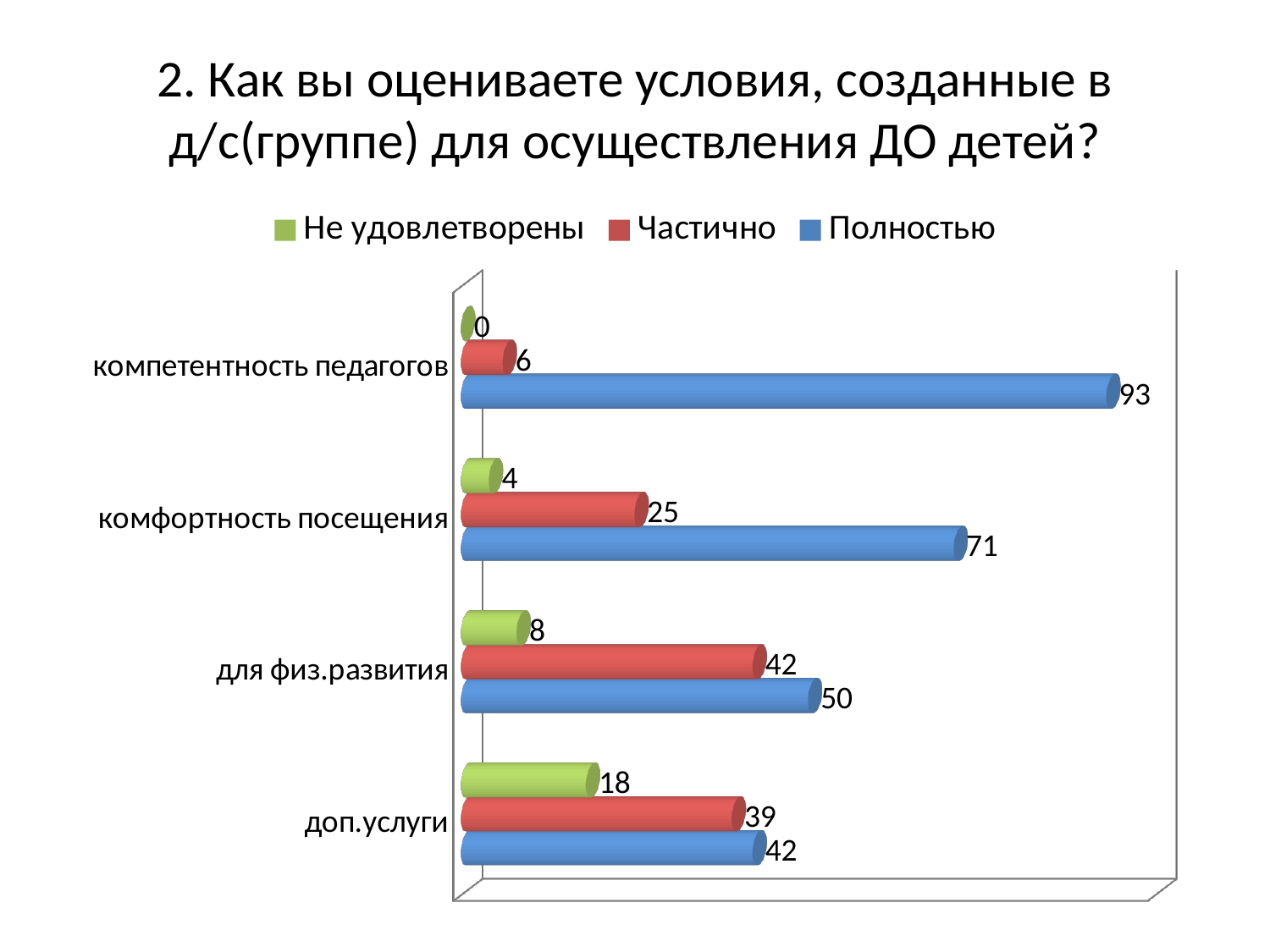
What is the value for "Не удовлетворены" for "доп.услуги"? 18 Which category has the highest value for "Полностью"? компетентность педагогов How many categories are shown on the chart? 4 Which category has the lowest value for "Частично"? компетентность педагогов What kind of chart is shown on the slide? bar chart Which colour represents the "Частично" series? red What is the value for "Частично" for "комфортность посещения"? 25 What is the value for "Не удовлетворены" for "компетентность педагогов"? 0 What is the difference between the "Полностью" and "Частично" values for "для физ.развития"? 8 Which is larger for "доп.услуги": the "Частично" value or the "Полностью" value? Полностью What is the value for "Полностью" for "компетентность педагогов"? 93 How many series does the legend list? 3